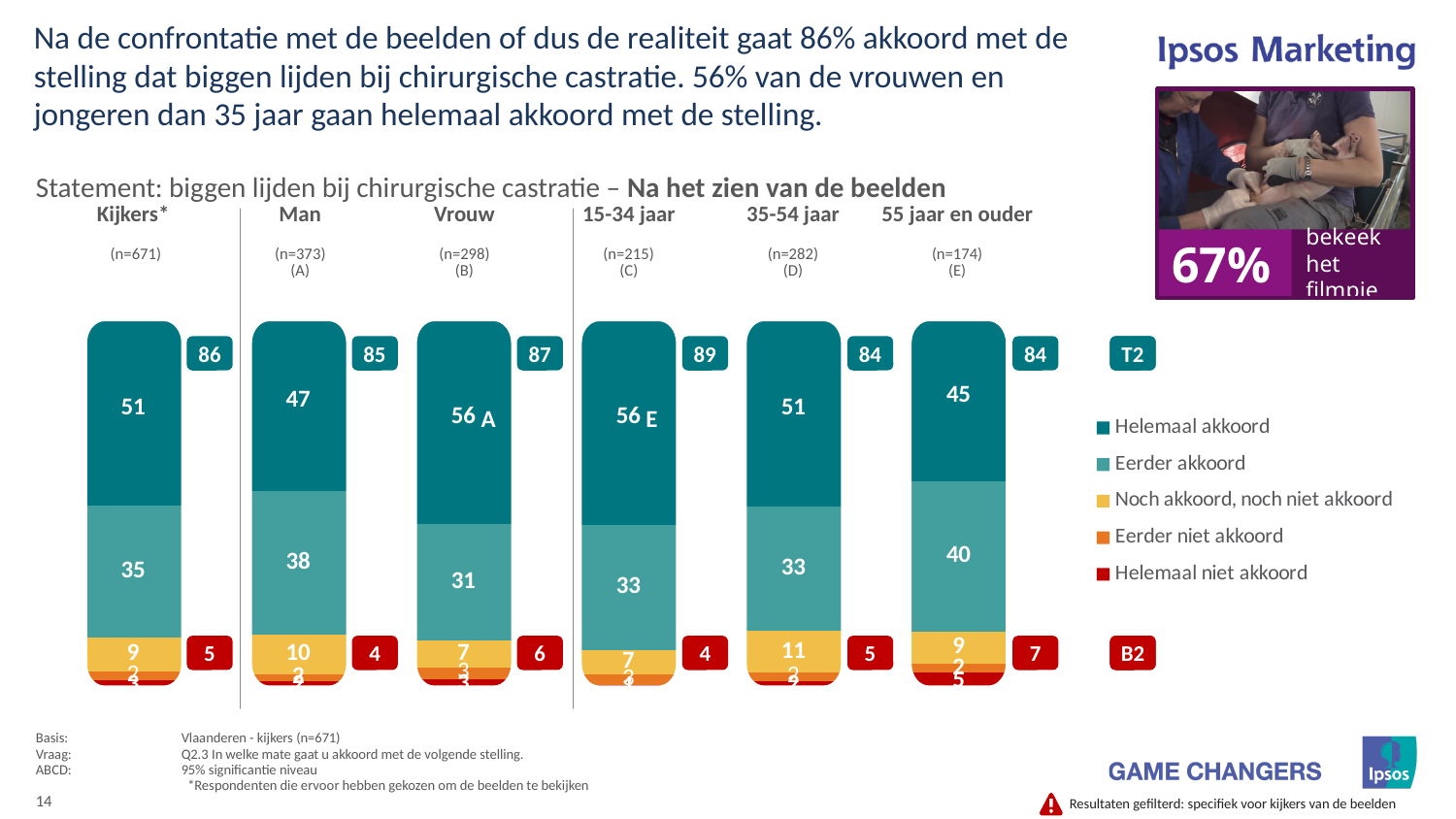
What is the T2 value shown for 15-34 jaar? 89 What is the 'Helemaal akkoord' value for Vrouw? 56 How many groups (bars) are plotted in the chart? 6 What is the 'Noch akkoord, noch niet akkoord' value for 35-54 jaar? 11 What is the B2 value shown for 55 jaar en ouder? 7 What is the difference between the 'Helemaal akkoord' values for Vrouw and Man? 9 Which group has the lowest 'Helemaal akkoord' value? 55 jaar en ouder How many series does the legend list? 5 What kind of chart is shown on the slide? stacked bar chart Which is larger, the 'Eerder akkoord' value for Man or for Vrouw? Man What is the 'Eerder akkoord' value for 55 jaar en ouder? 40 Which group has the highest T2 value? 15-34 jaar